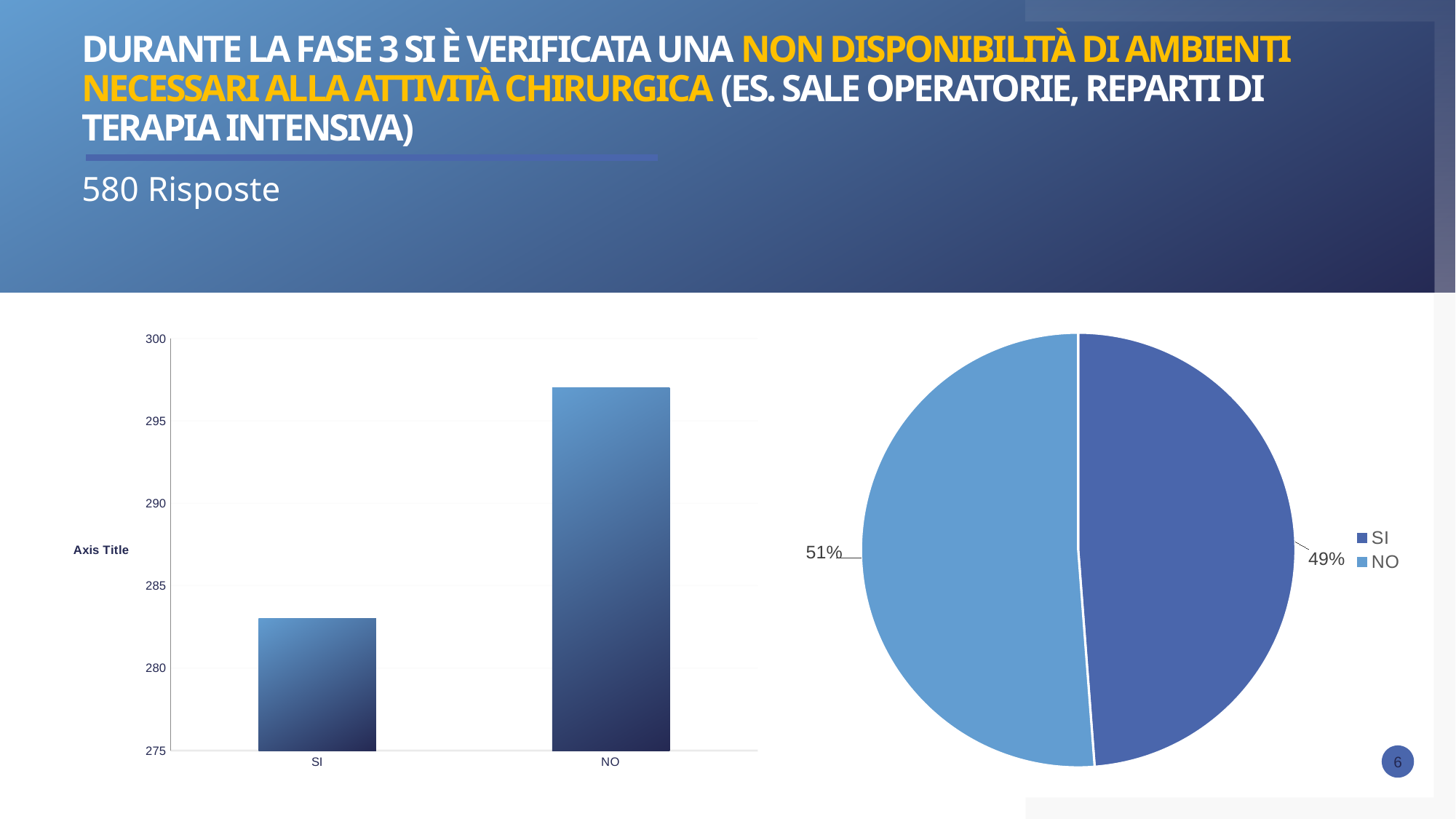
In the bar chart on the left, which category has the highest bar? NO In the bar chart on the left, which category has the lowest bar? SI In the bar chart on the left, how many categories are shown on the x axis? 2 In the bar chart on the left, what text is shown as the vertical axis title? Axis Title In the bar chart on the left, is the value for NO greater or less than 295? greater In the pie chart on the right, what share does the NO slice have? 51% In the bar chart on the left, which is larger, the bar for SI or the bar for NO? NO In the pie chart on the right, how many entries does the legend list? 2 What kind of chart is the chart on the right of the slide? pie chart In the bar chart on the left, is the value for SI greater or less than 285? less What kind of chart is the chart on the left of the slide? bar chart In the pie chart on the right, what share does the SI slice have? 49%